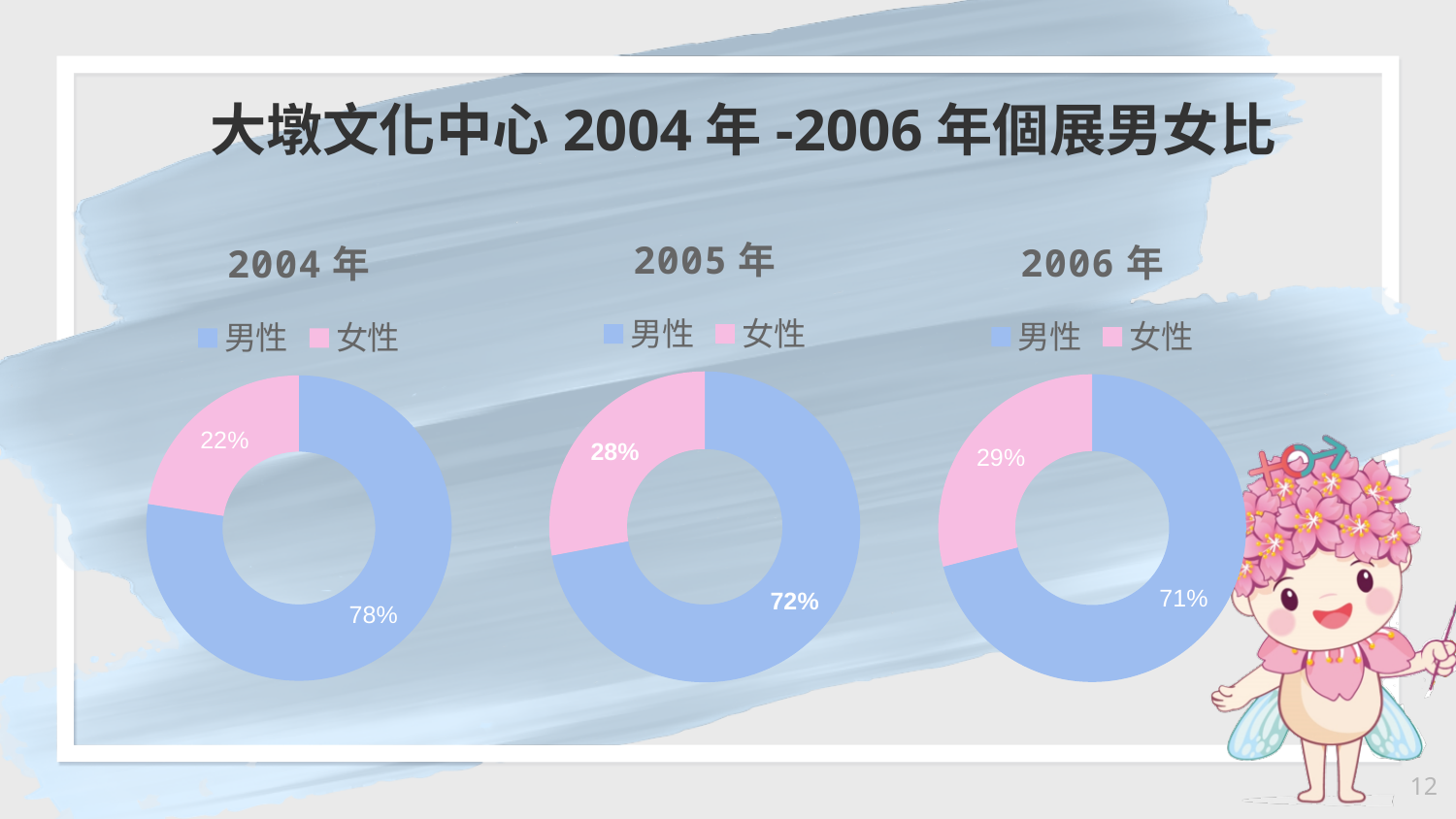
In the 2004 年 chart, what is the value for 男性? 78% In the 2005 年 chart, what is the value for 女性? 28% How many charts are shown on the slide? 3 In the 2006 年 chart, what is the value for 男性? 71% What kind of chart is the 2004 年 chart? Doughnut chart In the 2006 年 chart, which is larger, 男性 or 女性? 男性 In the 2006 年 chart, what is the value for 女性? 29% In the 2005 年 chart, which category has the largest share? 男性 How many series does the legend of the 2005 年 chart list? 2 In the 2004 年 chart, what is the value for 女性? 22% In the 2004 年 chart, which category has the smallest share? 女性 In the 2005 年 chart, what is the difference between the 男性 and 女性 values? 44%